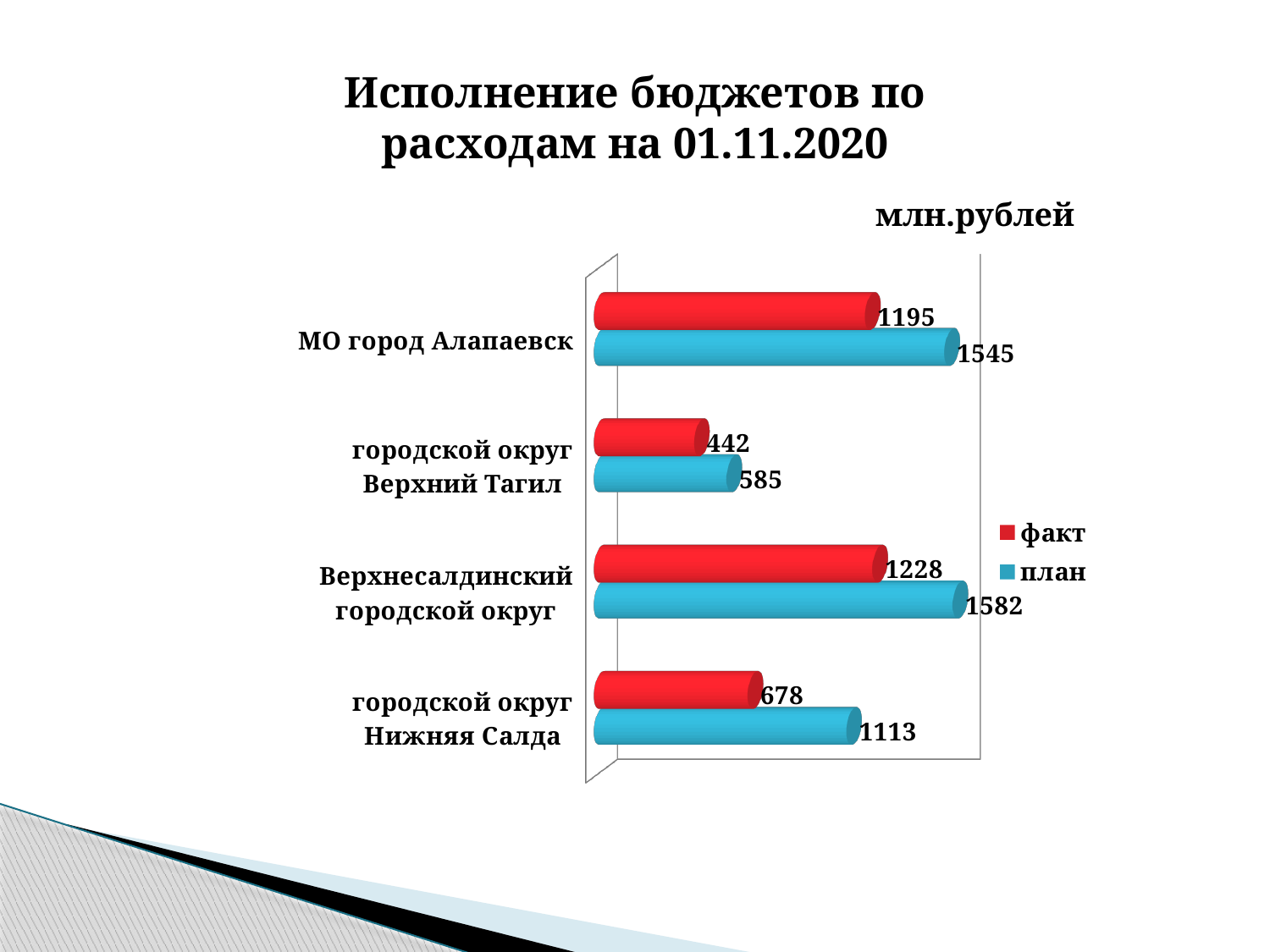
Which category has the lowest факт value? городской округ Верхний Тагил How many categories are shown on the chart? 4 What is the difference between план and факт for Верхнесалдинский городской округ? 354 Which colour represents the план series? blue Which is larger: the факт value for МО город Алапаевск or the факт value for Верхнесалдинский городской округ? Верхнесалдинский городской округ What is the план value for городской округ Нижняя Салда? 1113 What is the difference between план and факт for городской округ Нижняя Салда? 435 What kind of chart is shown on the slide? bar chart What is the факт value for городской округ Верхний Тагил? 442 What is the план value for МО город Алапаевск? 1545 How many series does the legend list? 2 Which category has the highest план value? Верхнесалдинский городской округ